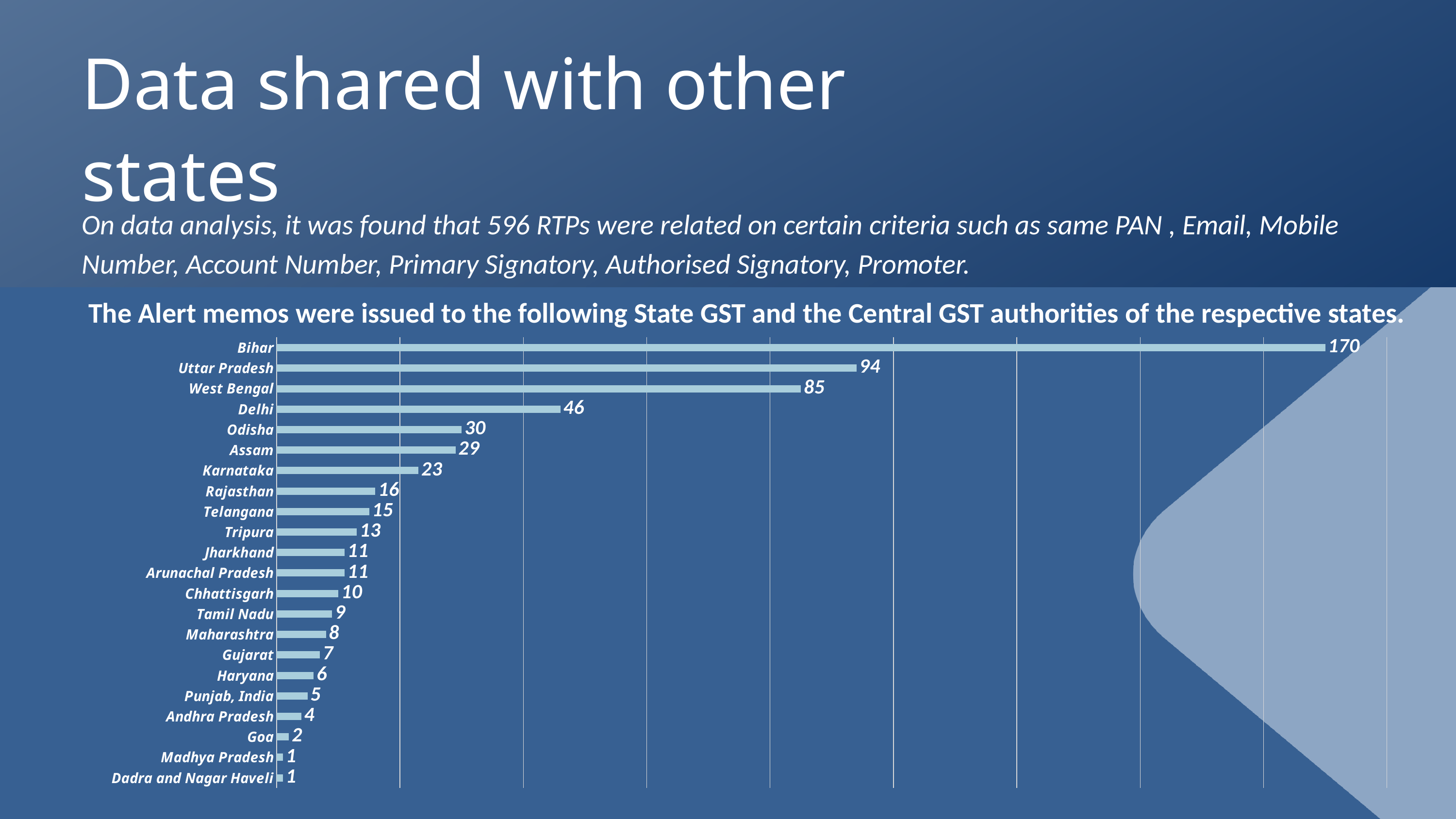
What is the value for Chhattisgarh? 10 What is the value for Uttar Pradesh? 94 Which has a larger value, Assam or Rajasthan? Assam What is the difference between the values for Bihar and Uttar Pradesh? 76 Which has a larger value, Gujarat or Tamil Nadu? Tamil Nadu What kind of chart is shown on the slide? bar chart Which state has the highest value in the chart? Bihar What is the value for Goa? 2 How many states are listed in the chart? 22 What is the value for West Bengal? 85 What is the difference between the values for Delhi and Odisha? 16 What is the value for Karnataka? 23